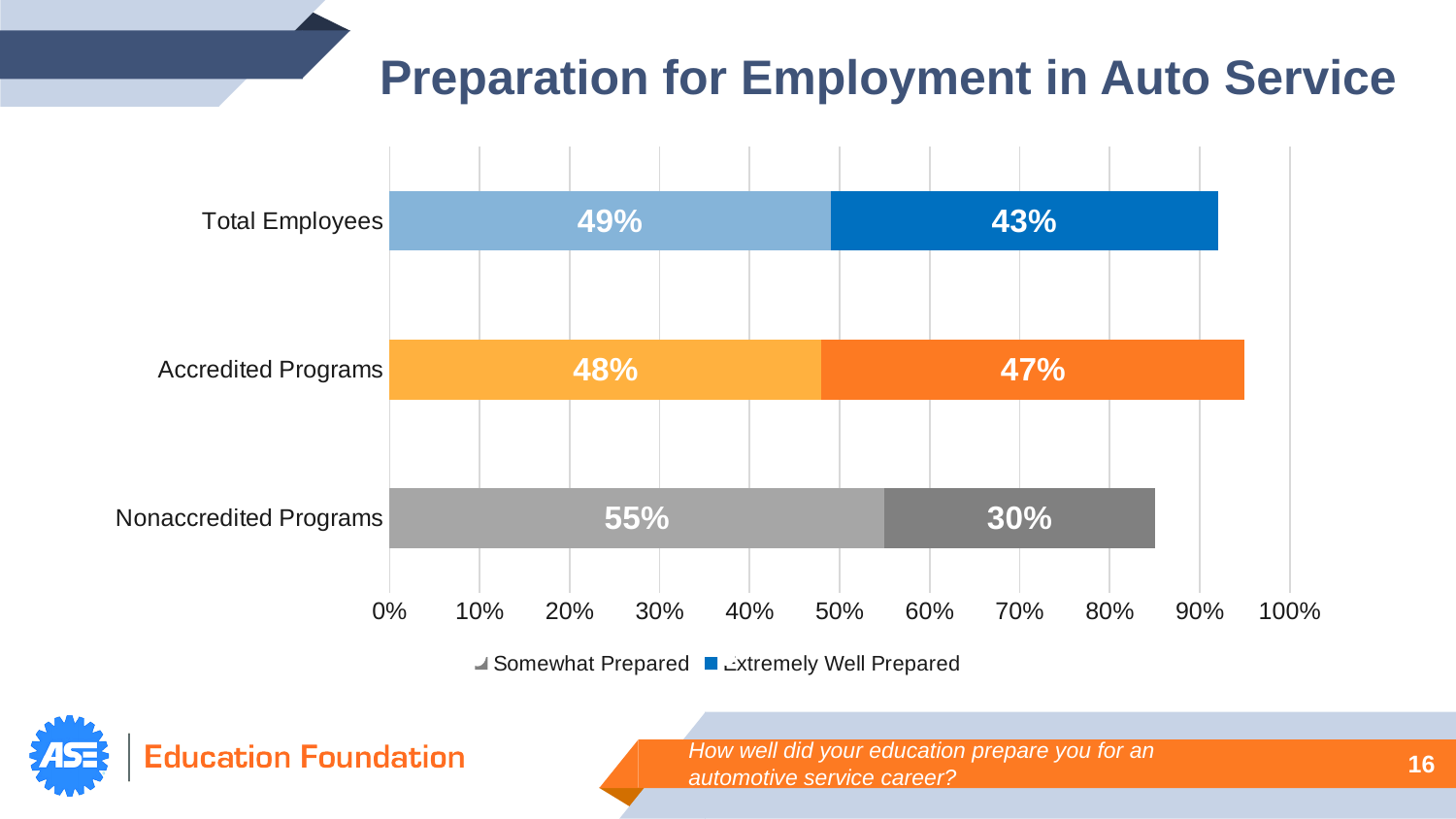
What is the title of the chart? Preparation for Employment in Auto Service What is the difference between the Somewhat Prepared and Extremely Well Prepared values for Nonaccredited Programs? 25% Which is larger: the Extremely Well Prepared value for Accredited Programs or for Total Employees? Accredited Programs What is the Extremely Well Prepared value for Accredited Programs? 47% Which category has the lowest Extremely Well Prepared value? Nonaccredited Programs What is the Extremely Well Prepared value for Nonaccredited Programs? 30% What kind of chart is shown on the slide? Stacked bar chart What is the total of the stacked bar for Accredited Programs? 95% How many series does the legend list? 2 What is the Somewhat Prepared value for Total Employees? 49% How many categories are shown on the chart? 3 Which category has the highest Somewhat Prepared value? Nonaccredited Programs